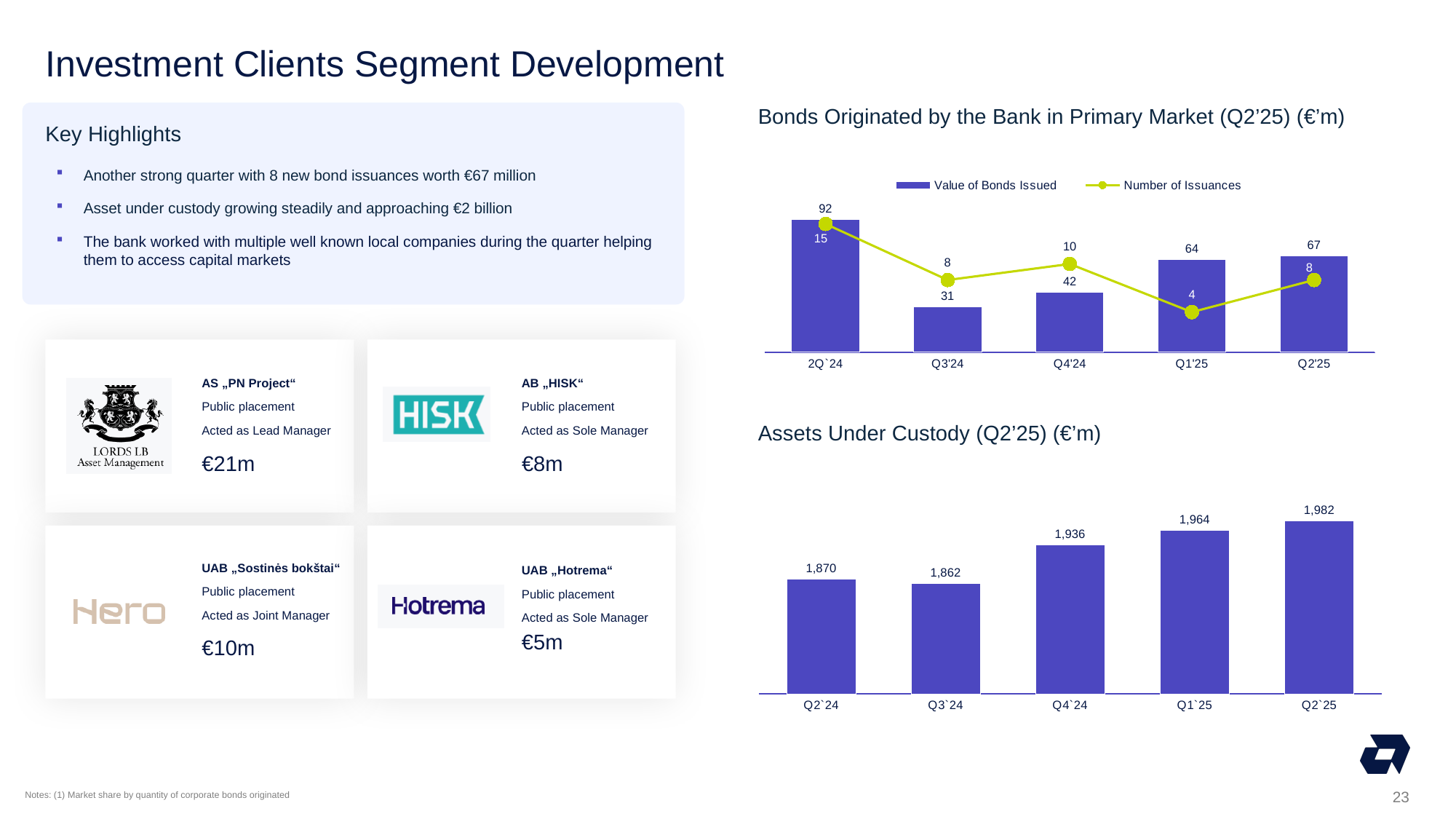
In the 'Bonds Originated by the Bank in Primary Market' chart, which quarter has the highest value of bonds issued? 2Q`24 In the 'Bonds Originated by the Bank in Primary Market' chart, how many series does the legend list? 2 In the 'Assets Under Custody' chart, which quarter has the lowest value? Q3`24 In the 'Assets Under Custody' chart, what is the difference between Q2`25 and Q2`24? 112 What type of chart is the 'Assets Under Custody' chart? Bar chart In the 'Bonds Originated by the Bank in Primary Market' chart, what is the number of issuances in Q1'25? 4 In the 'Bonds Originated by the Bank in Primary Market' chart, what is the difference between the value of bonds issued in 2Q`24 and Q2'25? 25 In the 'Assets Under Custody' chart, what is the value for Q1`25? 1,964 In the 'Assets Under Custody' chart, how many quarters are shown? 5 In the 'Bonds Originated by the Bank in Primary Market' chart, which series is shown as a line? Number of Issuances In the 'Bonds Originated by the Bank in Primary Market' chart, which quarter has the lowest value of bonds issued? Q3'24 In the 'Bonds Originated by the Bank in Primary Market' chart, what is the value of bonds issued in Q4'24? 42